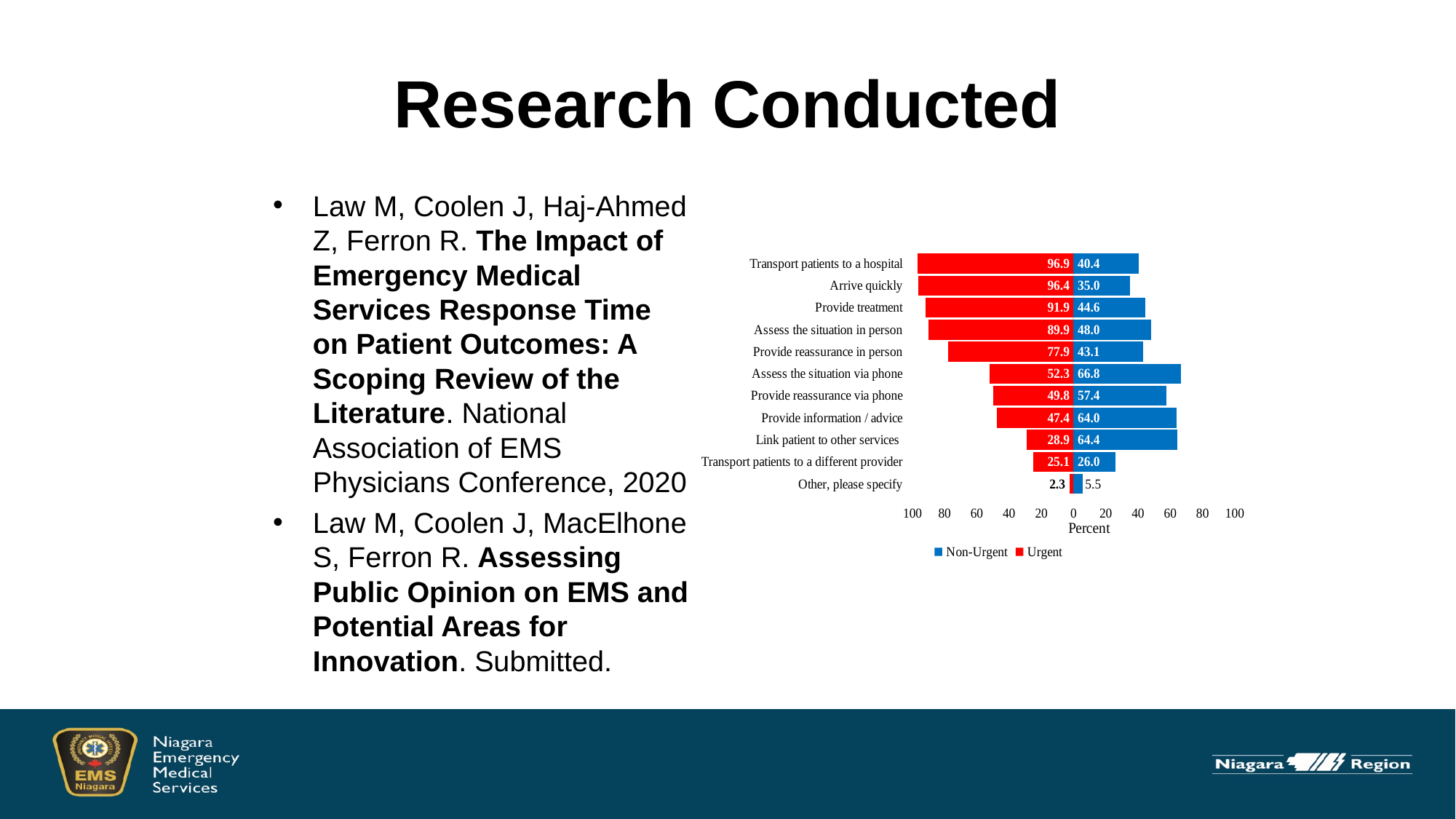
How many series does the legend list? 2 What is the Non-Urgent value for Assess the situation via phone? 66.8 For Provide information / advice, which is larger: the Urgent or the Non-Urgent value? Non-Urgent Which category has the highest Non-Urgent value? Assess the situation via phone Which category has the lowest Non-Urgent value? Other, please specify How many categories are shown in the chart? 11 What is the Urgent value for Provide reassurance in person? 77.9 What is the Urgent value for Transport patients to a hospital? 96.9 What kind of chart is shown on the slide? Bar chart What is the difference between the Urgent and Non-Urgent values for Transport patients to a hospital? 56.5 What is the Non-Urgent value for Link patient to other services? 64.4 Which category has the highest Urgent value? Transport patients to a hospital